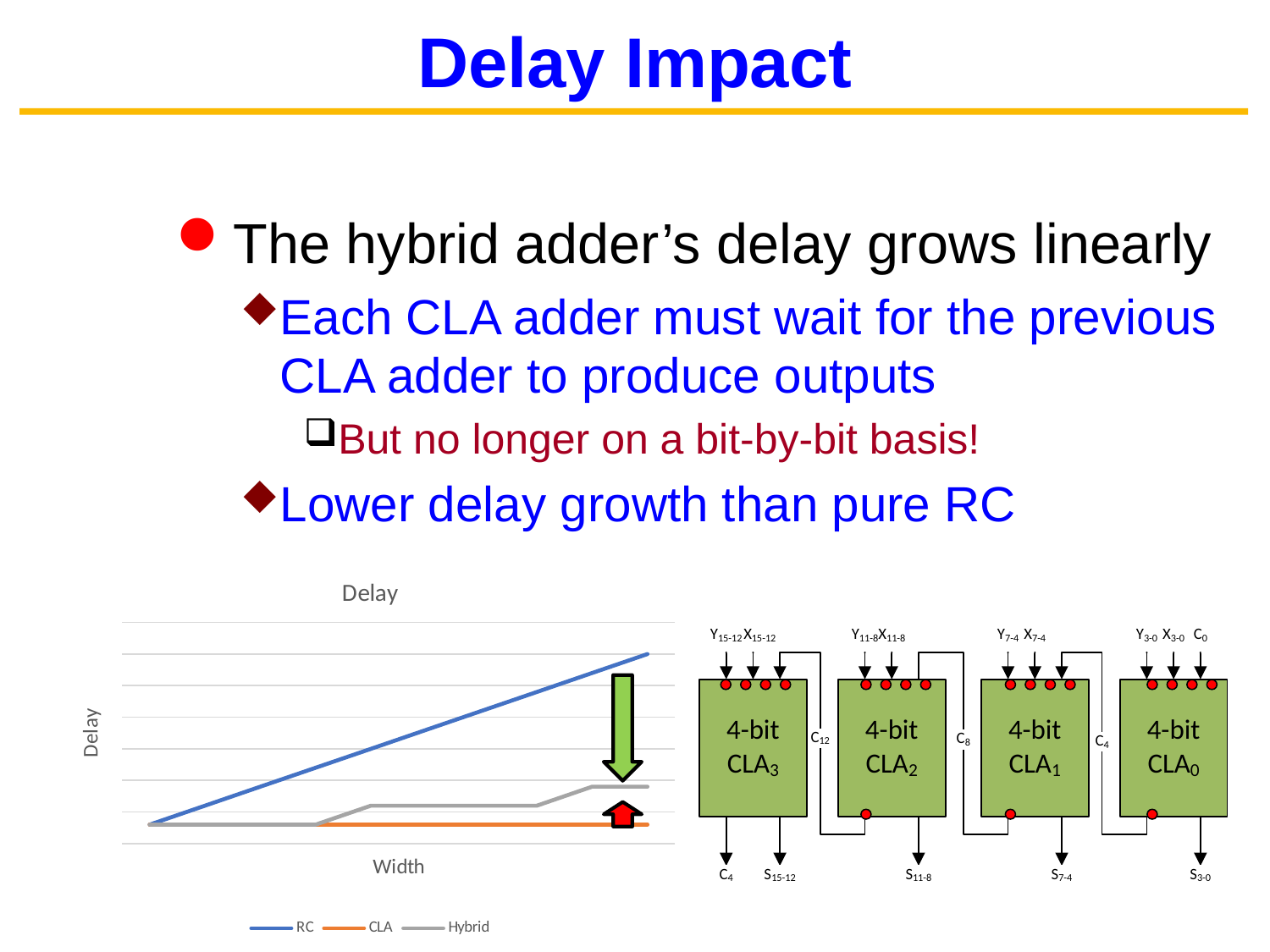
Does the CLA series rise, fall, or stay flat as Width increases? stay flat Does the RC series rise or fall as Width increases? rise How many series does the chart's legend list? 3 Which series reaches the highest delay at the largest width shown? RC Which series is drawn in blue on the chart? RC What is the label of the x axis of the chart? Width What is the title of the chart? Delay At the largest width shown, which series has the larger delay, RC or Hybrid? RC At the largest width shown, which series has the larger delay, Hybrid or CLA? Hybrid Which series has the lowest delay at the largest width shown? CLA What kind of chart is shown on the slide? line chart